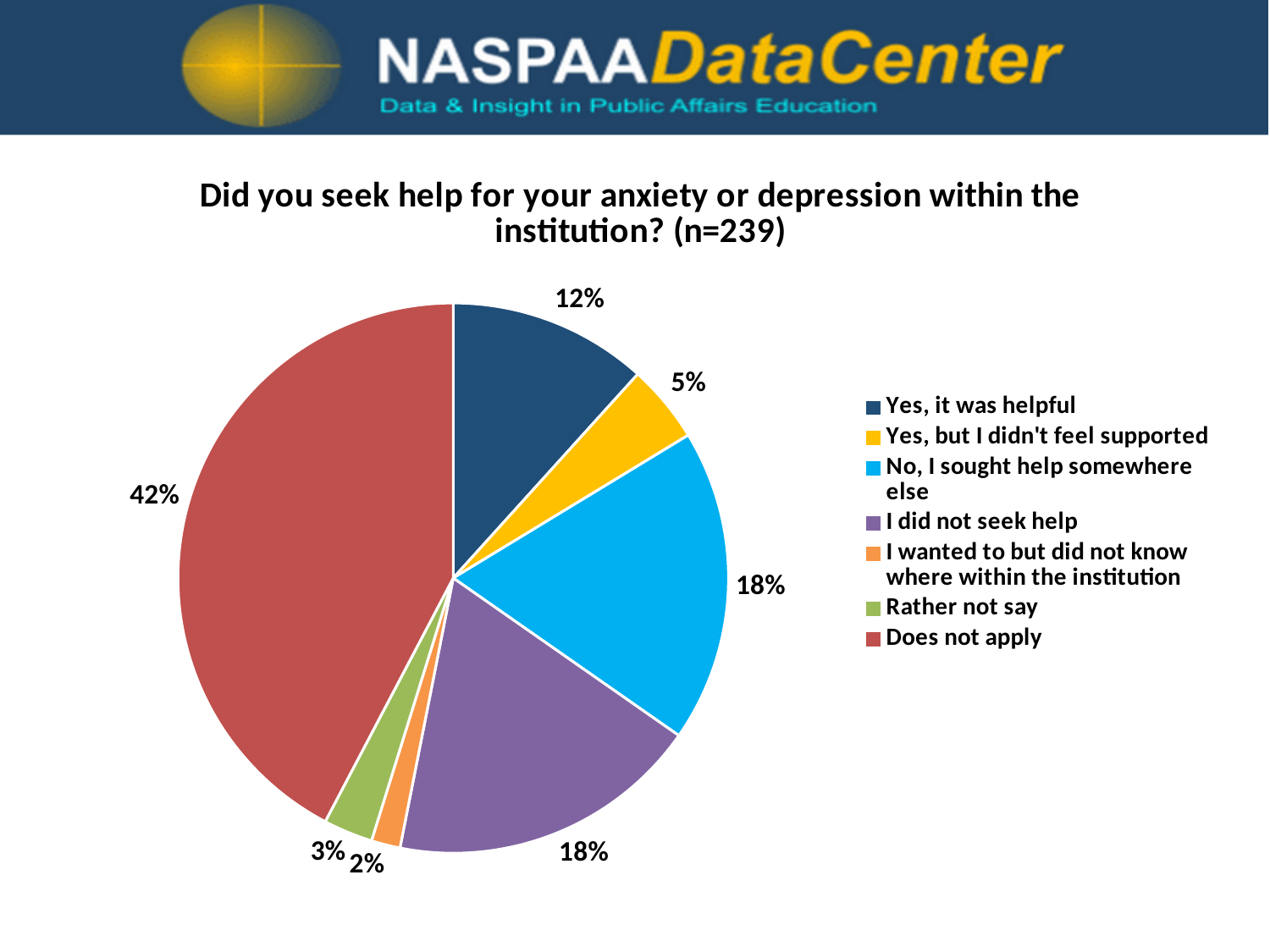
What share of respondents answered "Yes, but I didn't feel supported"? 5% What share of respondents answered "Does not apply"? 42% What share of respondents answered "Yes, it was helpful"? 12% Which is larger: the share for "Yes, it was helpful" or the share for "Yes, but I didn't feel supported"? Yes, it was helpful What share of respondents answered "I wanted to but did not know where within the institution"? 2% How many response categories does the legend list? 7 What is the sample size (n) given in the chart title? 239 Which response has the smallest slice of the pie? I wanted to but did not know where within the institution Which response has the largest slice of the pie? Does not apply What is the difference in percentage points between "Does not apply" and "No, I sought help somewhere else"? 24 What kind of chart is shown on the slide? Pie chart What share of respondents answered "Rather not say"? 3%